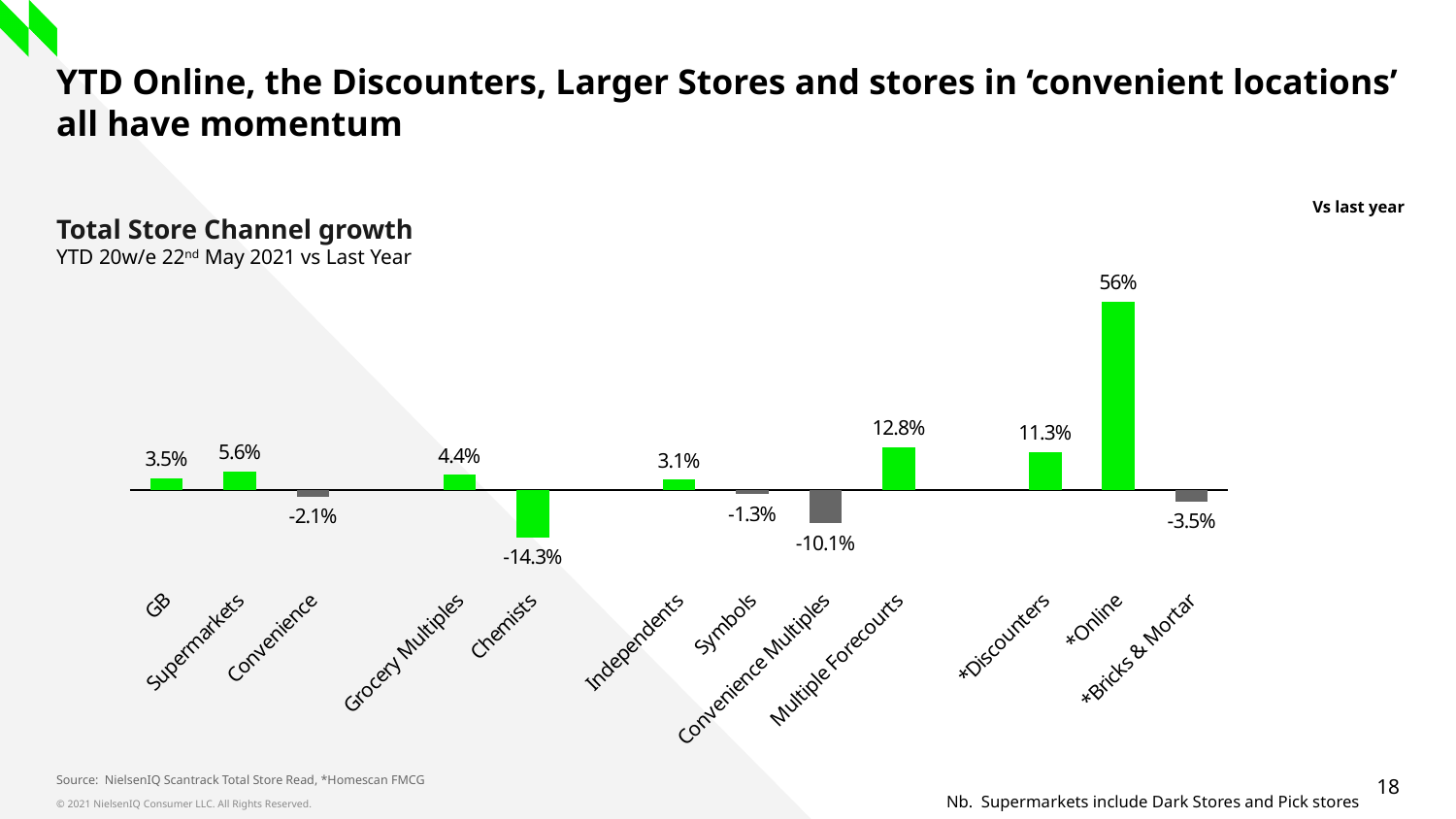
Which has higher growth, Supermarkets or Grocery Multiples? Supermarkets Which channel has the highest growth? *Online What is the title of the chart? Total Store Channel growth What kind of chart is shown on the slide? Bar chart What is the difference between the growth for *Online and *Discounters? 44.7% Which channel has the lowest growth? Chemists What is the growth value for *Online? 56% How many channels are shown in the chart? 12 What is the growth value for Multiple Forecourts? 12.8% What is the growth value for Convenience? -2.1% What colour are the bars with negative growth values? Grey What is the growth value for Chemists? -14.3%